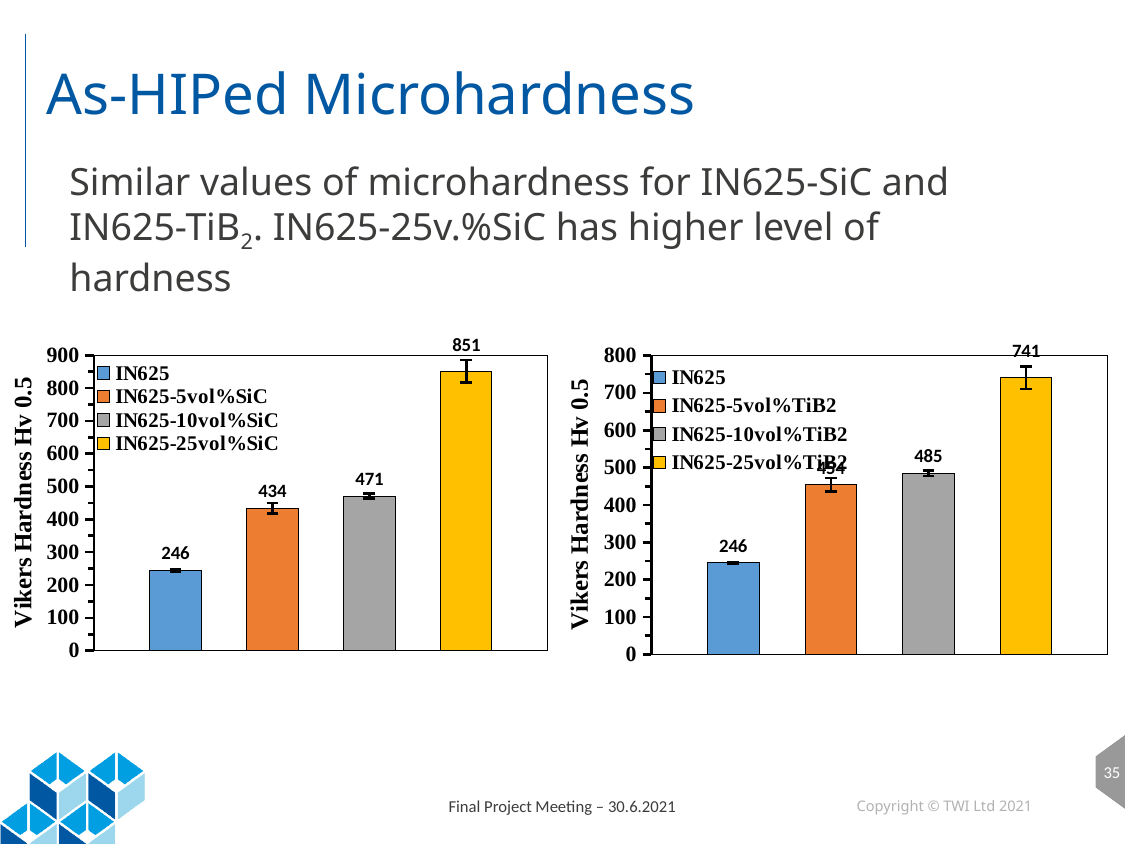
Which is larger: the hardness of IN625-25vol%SiC in the left chart or IN625-25vol%TiB2 in the right chart? IN625-25vol%SiC In the left chart (SiC), what is the difference between the hardness of IN625-25vol%SiC and IN625? 605 In the right chart (TiB2), what is the Vickers hardness value for IN625-25vol%TiB2? 741 In the right chart (TiB2), what is the difference between the hardness of IN625-25vol%TiB2 and IN625-10vol%TiB2? 256 In the left chart (SiC), which series has the highest hardness value? IN625-25vol%SiC What type of chart is the left chart (SiC)? Bar chart In the left chart (SiC), what is the Vickers hardness value for IN625-10vol%SiC? 471 In the right chart (TiB2), which series has the lowest hardness value? IN625 How many series does the legend of the right chart (TiB2) list? 4 In the left chart (SiC), what is the Vickers hardness value for IN625-5vol%SiC? 434 In the right chart (TiB2), what is the Vickers hardness value for IN625-10vol%TiB2? 485 In the left chart (SiC), what is the Vickers hardness value for IN625-25vol%SiC? 851